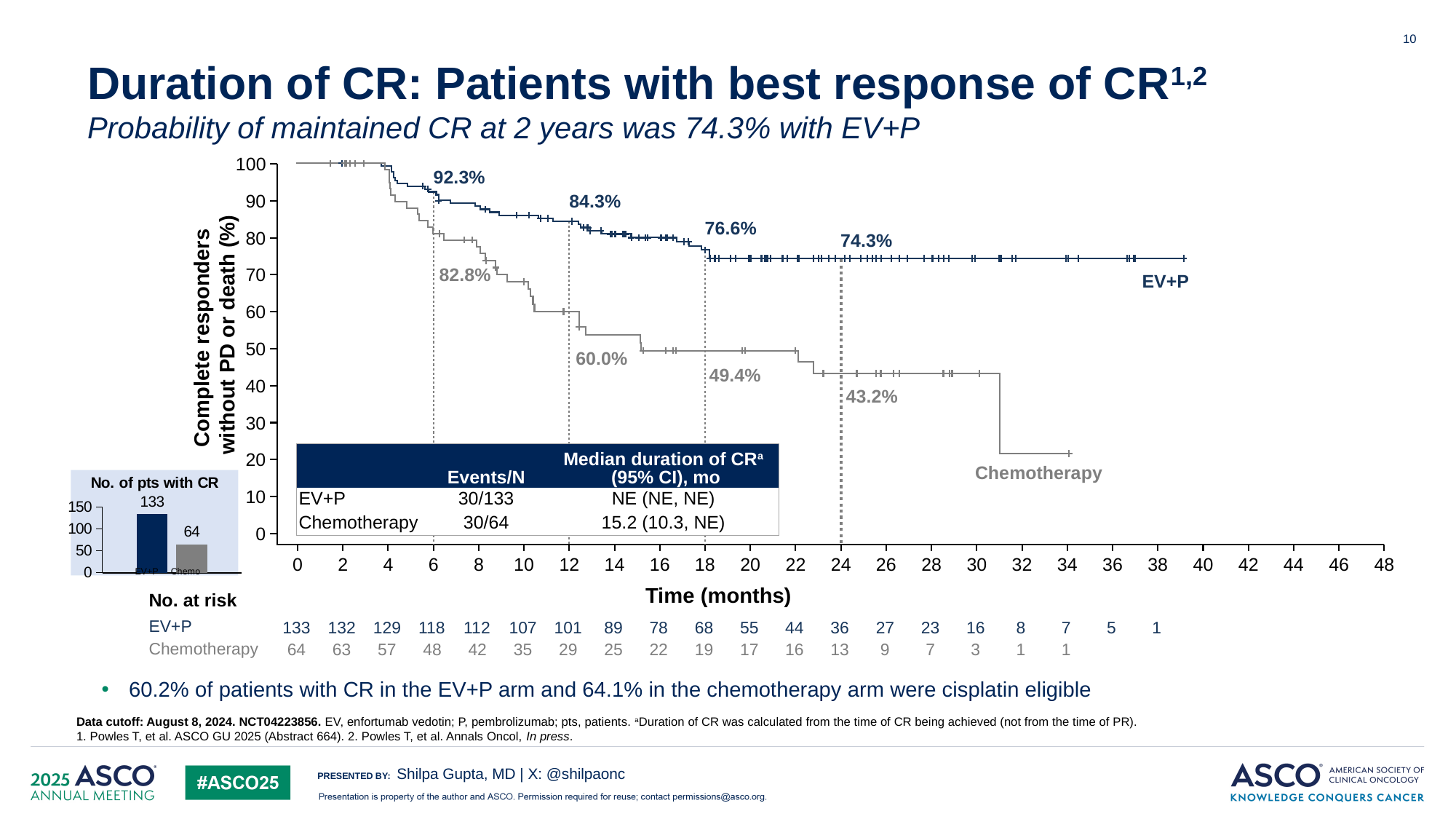
In the small 'No. of pts with CR' bar chart, what is the difference between the EV+P and Chemo values? 69 In the small 'No. of pts with CR' bar chart, what is the value for Chemo? 64 In the main Duration of CR chart, does the Chemotherapy curve rise or fall as time increases? fall In the main Duration of CR chart, is the EV+P curve at 36 months greater or less than 70? greater In the main Duration of CR chart, what is the labelled probability for EV+P at 24 months? 74.3% In the main Duration of CR chart, what is the x-axis label? Time (months) What kind of chart is the small 'No. of pts with CR' chart? bar chart In the main Duration of CR chart, what is the difference between the EV+P and Chemotherapy labelled values at 18 months? 27.2 percentage points In the small 'No. of pts with CR' bar chart, what is the value for EV+P? 133 In the main Duration of CR chart, what is the labelled probability for Chemotherapy at 12 months? 60.0% In the main Duration of CR chart, how many EV+P patients are at risk at 12 months according to the number-at-risk table? 101 In the main Duration of CR chart, which arm has the higher labelled value at 6 months, EV+P or Chemotherapy? EV+P